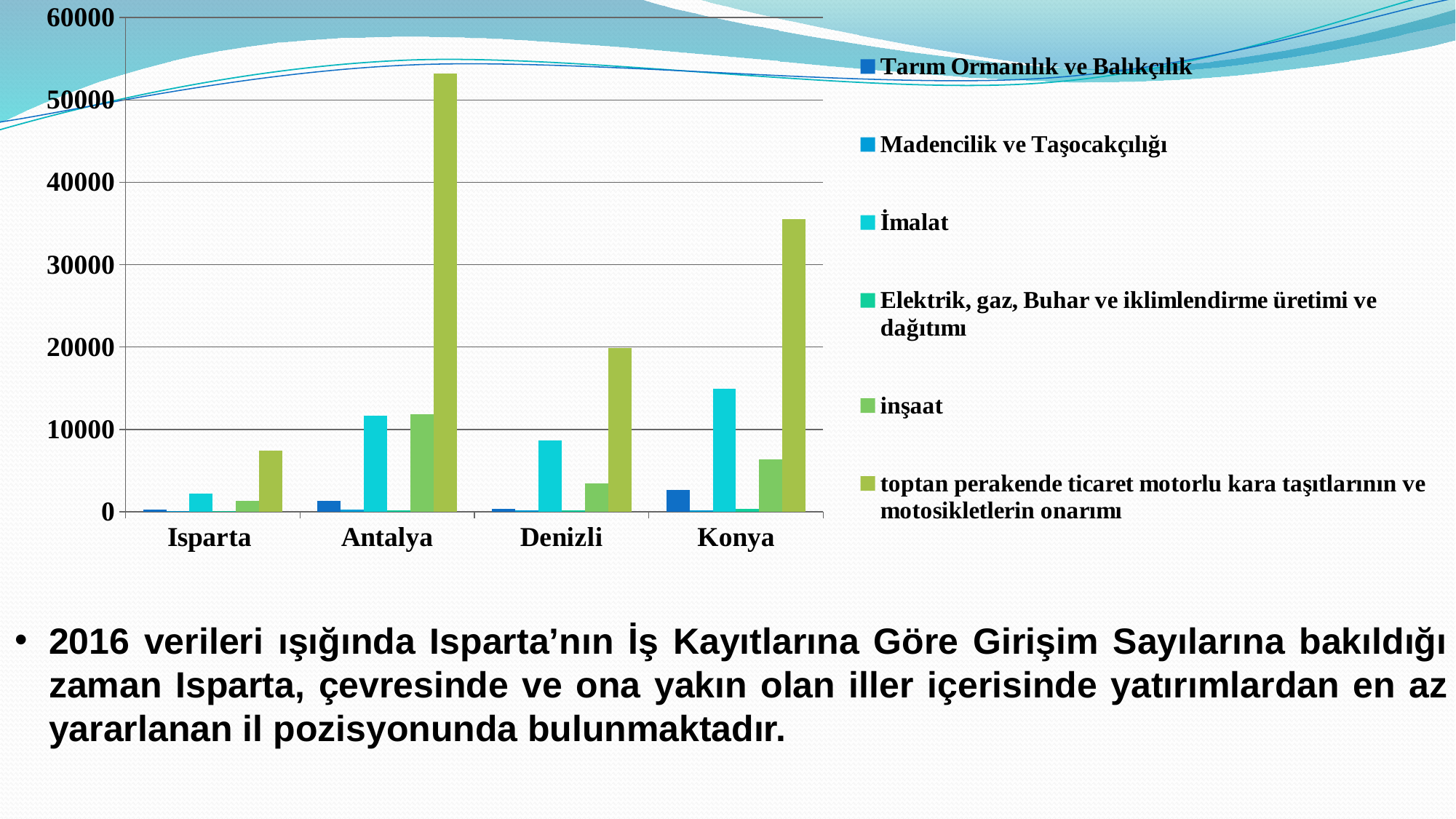
Which city has the lowest value for 'inşaat'? Isparta Which is larger, the 'inşaat' value for Antalya or for Konya? Antalya Which city has the lowest value for 'toptan perakende ticaret motorlu kara taşıtlarının ve motosikletlerin onarımı'? Isparta What kind of chart is shown on the slide? bar chart Is the value for 'toptan perakende ticaret motorlu kara taşıtlarının ve motosikletlerin onarımı' in Antalya greater or less than 50000? greater Which city has the highest value for 'toptan perakende ticaret motorlu kara taşıtlarının ve motosikletlerin onarımı'? Antalya Which city is listed first on the x axis of the chart? Isparta Is the value for 'toptan perakende ticaret motorlu kara taşıtlarının ve motosikletlerin onarımı' in Konya greater or less than 30000? greater How many series does the chart's legend list? 6 How many cities are shown on the x axis of the chart? 4 Which city has the highest value for 'İmalat'? Konya Is the value for 'İmalat' in Denizli greater or less than 10000? less